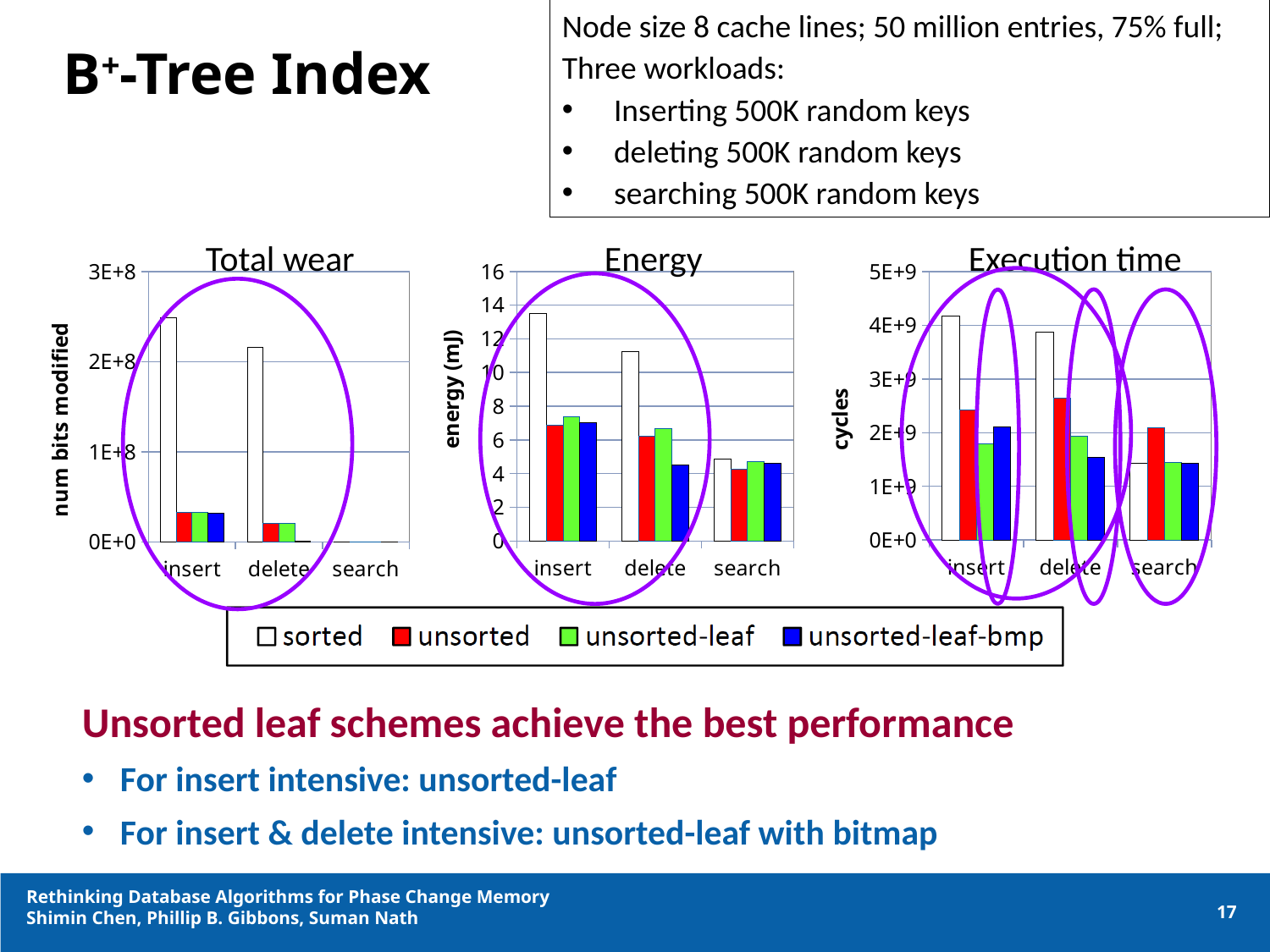
In the Energy chart, is the value for sorted on insert greater or less than 12? greater How many series does the legend list for the charts? 4 What is the y-axis label of the Energy chart? energy (mJ) In the Execution time chart, which series has the lowest value for delete? unsorted-leaf-bmp What kind of chart is the Total wear chart? bar chart In the Total wear chart, do the sorted values rise or fall from insert to search? fall In the Total wear chart, is the value for sorted on insert greater or less than 2E+8? greater In the Energy chart, which is larger for insert: sorted or unsorted? sorted How many categories are shown on the x axis of the Energy chart? 3 In the Energy chart, which series has the highest value for insert? sorted In the Energy chart, is the value for sorted on delete greater or less than 10? greater